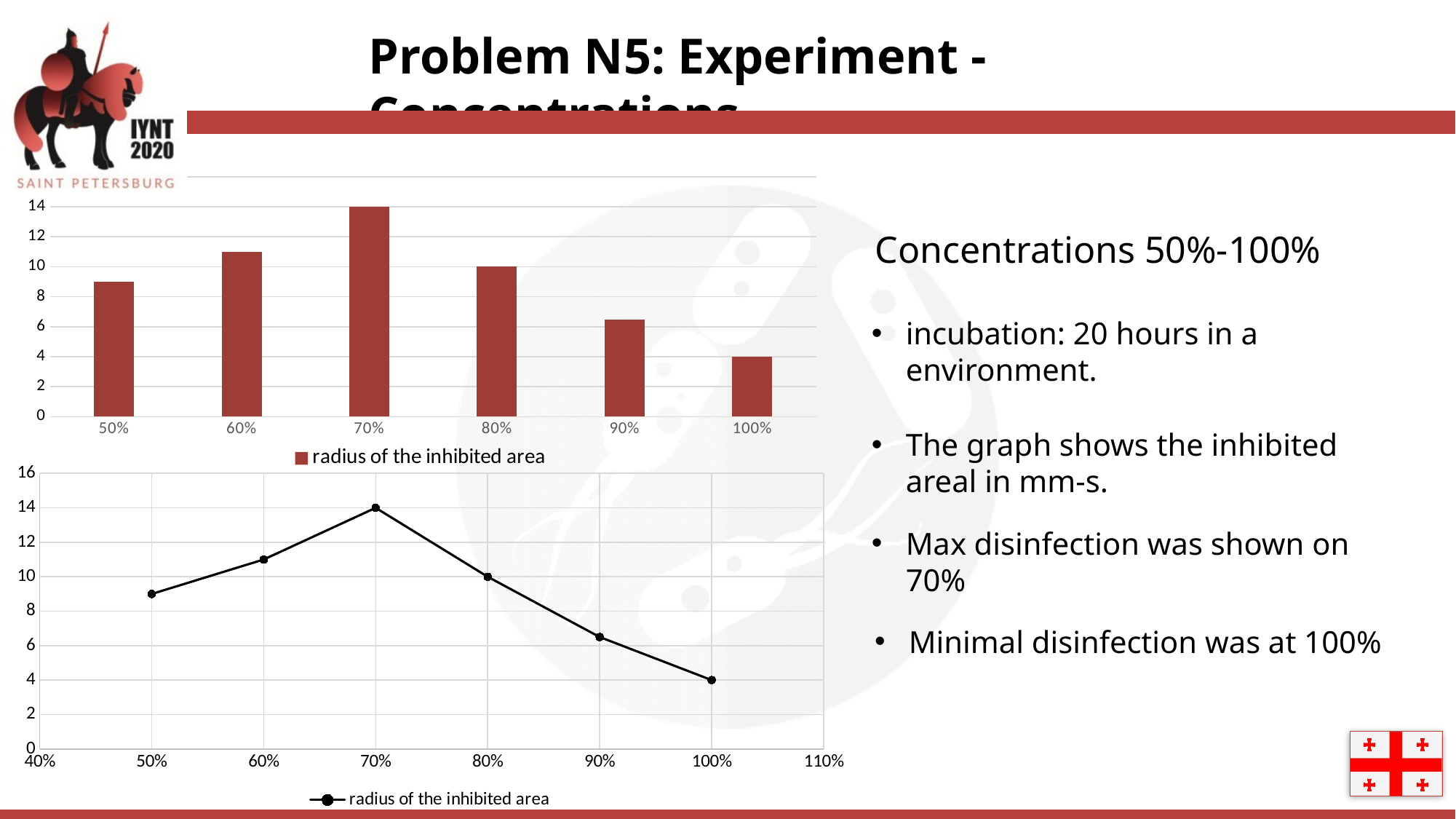
What is the legend entry of the bottom line chart? radius of the inhibited area In the top bar chart, is the value for 50% greater or less than 8? greater In the top bar chart, what is the radius of the inhibited area at 100%? 4 In the top bar chart, what is the difference between the values at 70% and 100%? 10 In the top bar chart, which concentration has the highest radius of the inhibited area? 70% What type of chart is the bottom chart on the slide? line chart In the bottom line chart, is the value for 90% greater or less than 8? less In the top bar chart, how many concentration categories are shown? 6 In the bottom line chart, which concentration has the lowest value? 100% In the bottom line chart, what is the value at 80%? 10 In the top bar chart, what is the radius of the inhibited area at 70%? 14 What type of chart is the top chart on the slide? bar chart